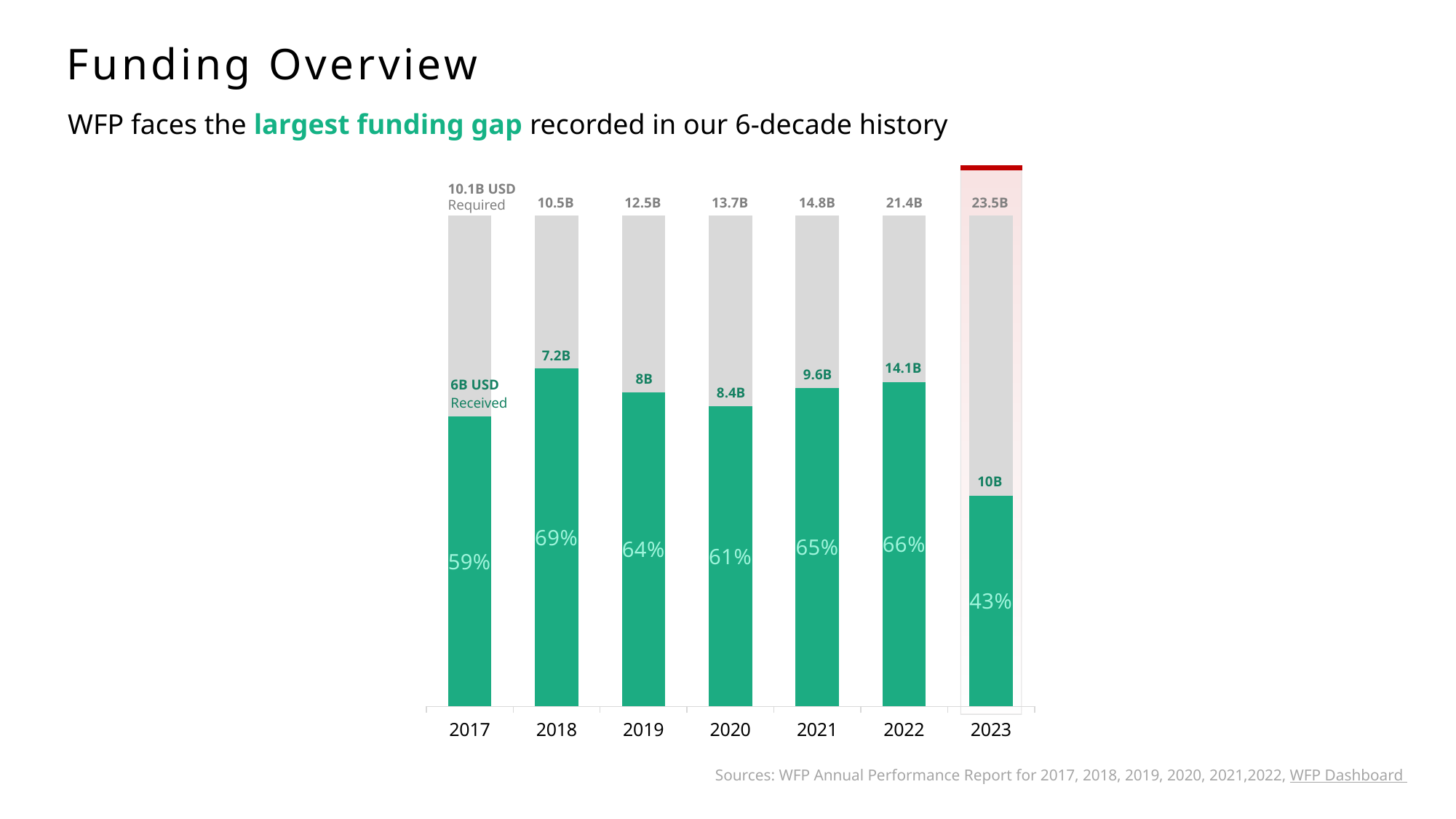
What kind of chart is shown on the slide? Bar chart Which year has the highest percentage of required funding received? 2018 What percentage of required funding was received in 2018? 69% How many years are shown on the x axis? 7 What amount of funding was received in 2017? 6B USD Which year has the lowest percentage of required funding received? 2023 What is the difference between the required and received funding in 2023? 13.5B What colour represents the funding received in the chart? Green Which year has the highest required funding? 2023 What amount of funding was required in 2023? 23.5B What amount of funding was received in 2022? 14.1B Which year had more funding received, 2019 or 2021? 2021